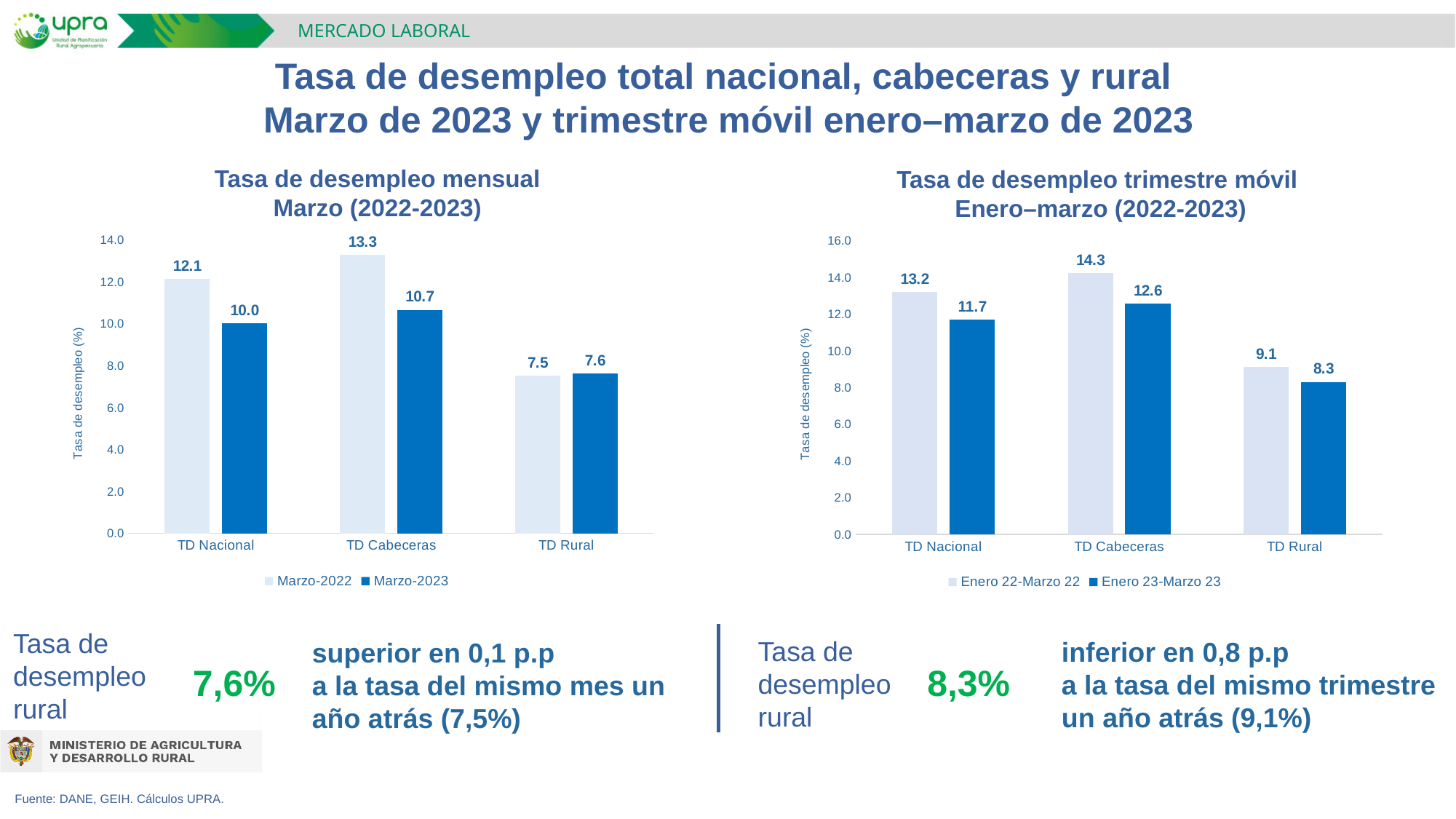
In the right chart (Tasa de desempleo trimestre móvil), what is the difference between the Enero 22-Marzo 22 and Enero 23-Marzo 23 values for TD Rural? 0.8 In the left chart (Tasa de desempleo mensual Marzo), how many series does the legend list? 2 In the right chart (Tasa de desempleo trimestre móvil), what is the value for TD Nacional in Enero 23-Marzo 23? 11.7 In the left chart (Tasa de desempleo mensual Marzo), what is the value for TD Rural in Marzo-2022? 7.5 What type of chart is the right chart (Tasa de desempleo trimestre móvil)? Bar chart In the left chart (Tasa de desempleo mensual Marzo), what is the difference between the Marzo-2022 and Marzo-2023 values for TD Nacional? 2.1 In the left chart (Tasa de desempleo mensual Marzo), what is the value for TD Cabeceras in Marzo-2023? 10.7 In the left chart (Tasa de desempleo mensual Marzo), which category has the lowest value for Marzo-2023? TD Rural In the left chart (Tasa de desempleo mensual Marzo), which is larger for TD Rural: the Marzo-2022 value or the Marzo-2023 value? Marzo-2023 In the right chart (Tasa de desempleo trimestre móvil), how many categories are shown on the x axis? 3 In the right chart (Tasa de desempleo trimestre móvil), what are the two legend entries? Enero 22-Marzo 22 and Enero 23-Marzo 23 In the right chart (Tasa de desempleo trimestre móvil), which category has the highest value for Enero 22-Marzo 22? TD Cabeceras